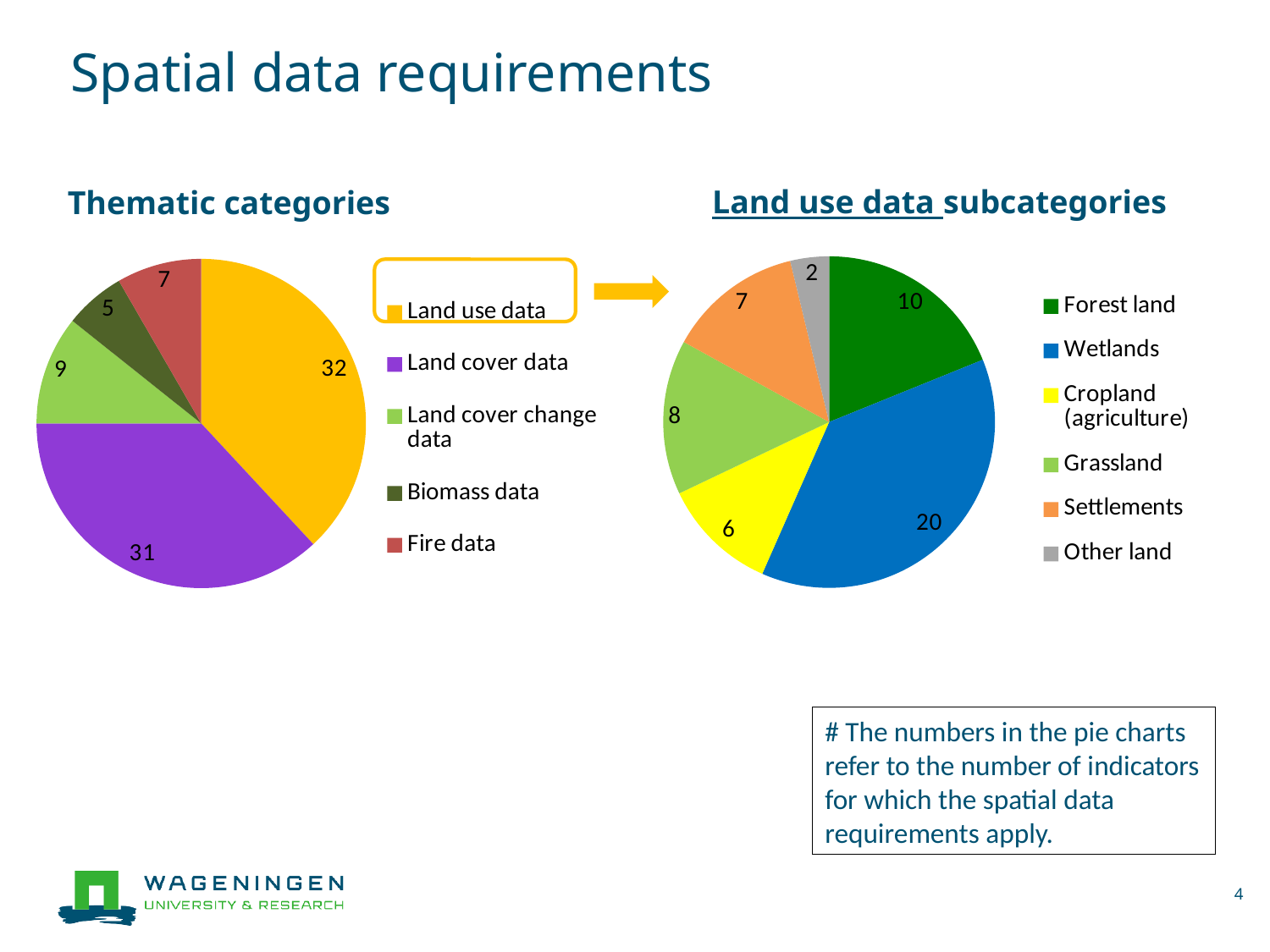
In the Land use data subcategories pie chart, what is the value for Settlements? 7 In the Thematic categories pie chart, how many categories are shown? 5 In the Land use data subcategories pie chart, which subcategory has the smallest value? Other land In the Thematic categories pie chart, what is the value for Land cover change data? 9 In the Land use data subcategories pie chart, what is the value for Wetlands? 20 In the Thematic categories pie chart, what is the value for Land use data? 32 In the Thematic categories pie chart, what is the difference between Land use data and Fire data? 25 What type of chart is used for the Thematic categories? Pie chart In the Land use data subcategories pie chart, which subcategory has the largest value? Wetlands In the Land use data subcategories pie chart, how many subcategories does the legend list? 6 In the Thematic categories pie chart, which category has the smallest value? Biomass data In the Land use data subcategories pie chart, which is larger, Grassland or Cropland (agriculture)? Grassland